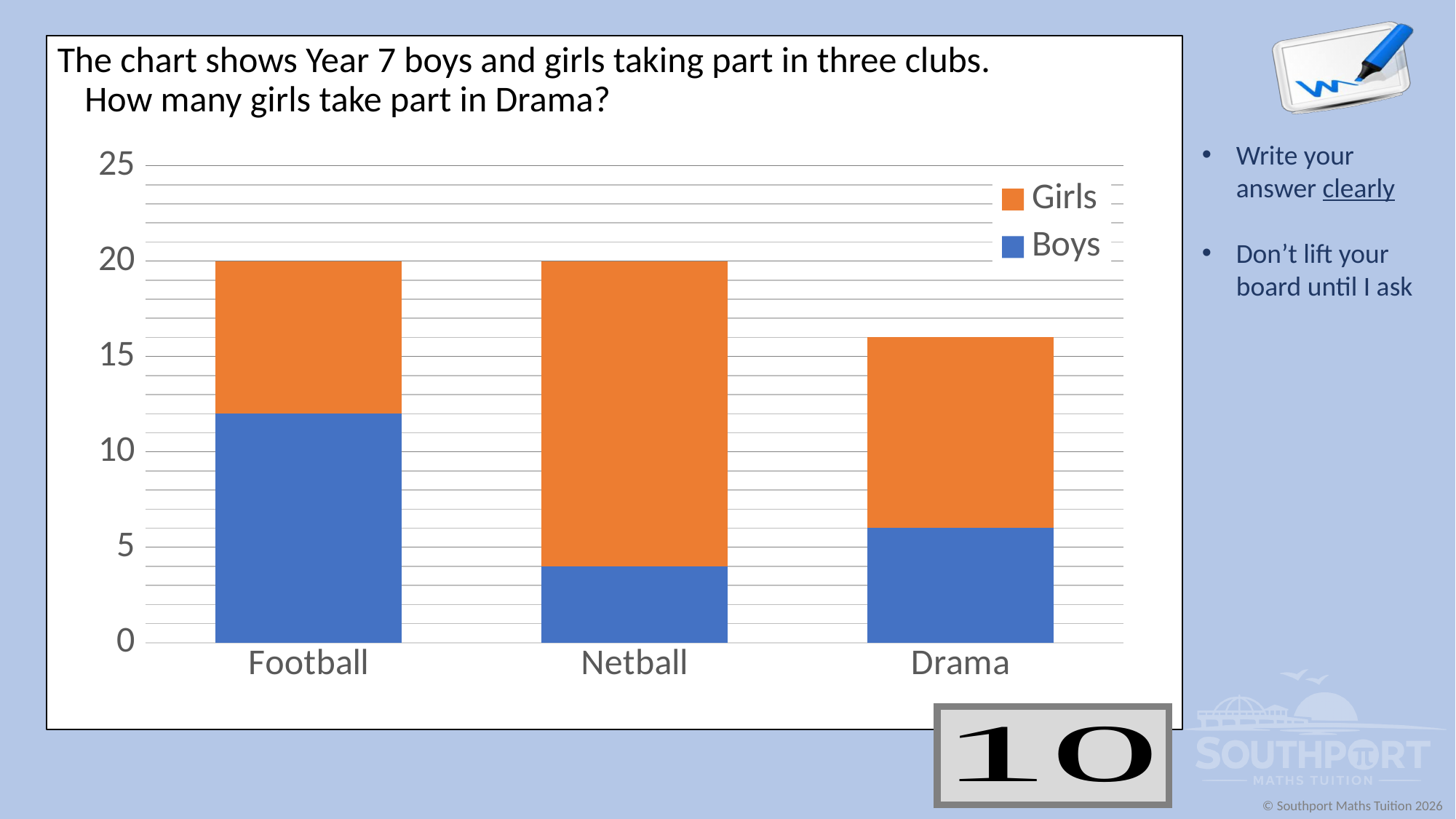
Which club has more Boys, Football or Netball? Football What is the total number of pupils in the Netball bar? 20 Which colour represents Girls in the chart? orange Which club has the lowest total bar? Drama Is the number of Boys in Netball greater or less than 5? less How many series does the chart's legend list? 2 How many clubs are shown on the x axis of the chart? 3 What kind of chart is shown on the slide? stacked bar chart What is the total number of pupils in the Football bar? 20 Is the total for Drama greater or less than 20? less What are the two series named in the chart's legend? Girls and Boys Is the number of Boys in Football greater or less than 10? greater